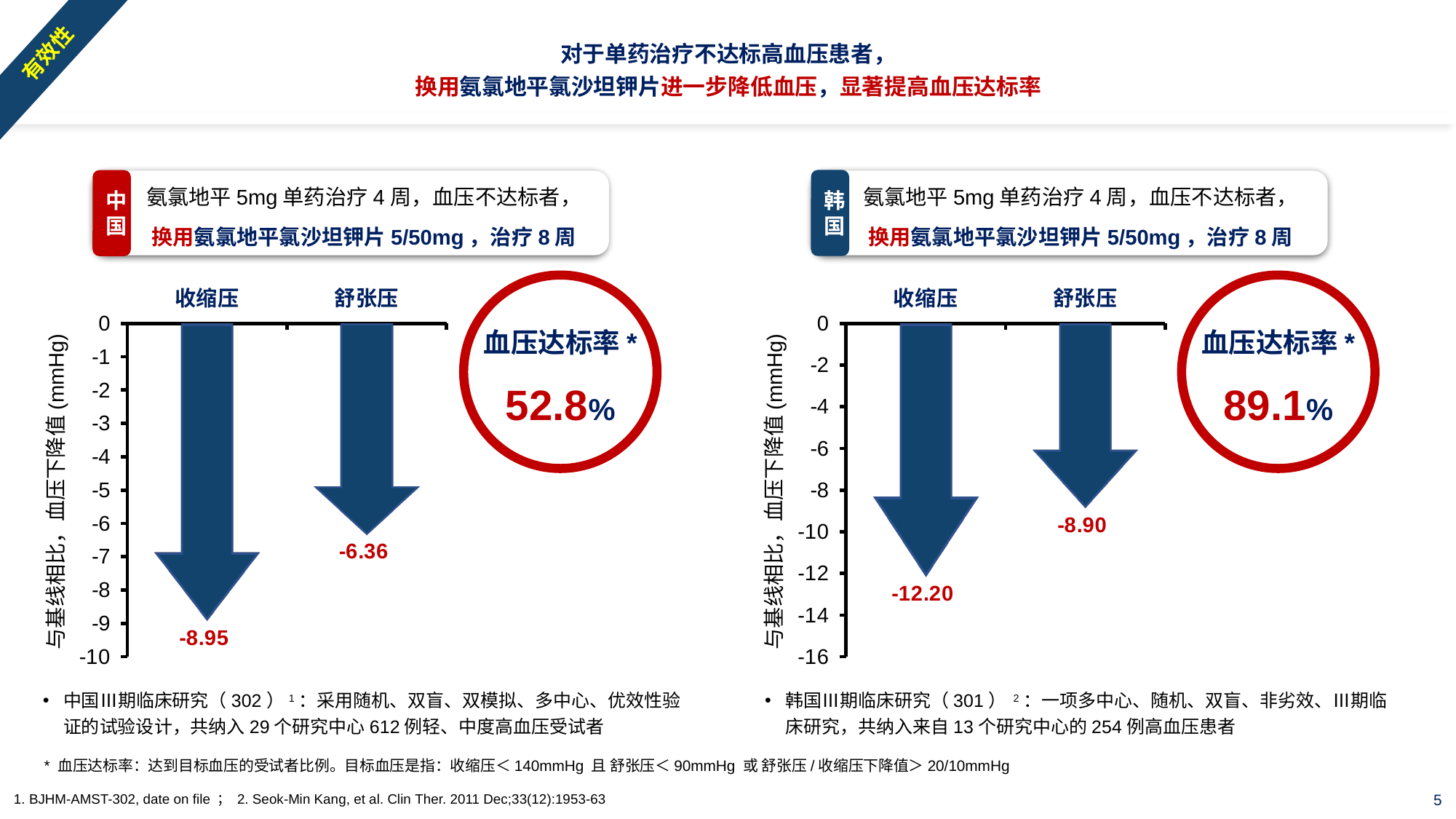
In the right (韩国) chart, what is the difference between the 收缩压 and 舒张压 values? 3.30 Is the 收缩压 value in the right (韩国) chart greater or less than -10? less In the left (中国) chart, what is the value for 收缩压? -8.95 In the right (韩国) chart, which category has the lowest (most negative) value? 收缩压 In the right (韩国) chart, what is the value for 舒张压? -8.90 In the left (中国) chart, what is the value for 舒张压? -6.36 How many categories are plotted in the left (中国) chart? 2 In the right (韩国) chart, what is the value for 收缩压? -12.20 In the left (中国) chart, what is the difference between the 收缩压 and 舒张压 values? 2.59 What is the y-axis label of the left (中国) chart? 与基线相比，血压下降值 (mmHg) What kind of chart is the right (韩国) chart? bar chart In the left (中国) chart, which category shows the larger reduction from baseline? 收缩压